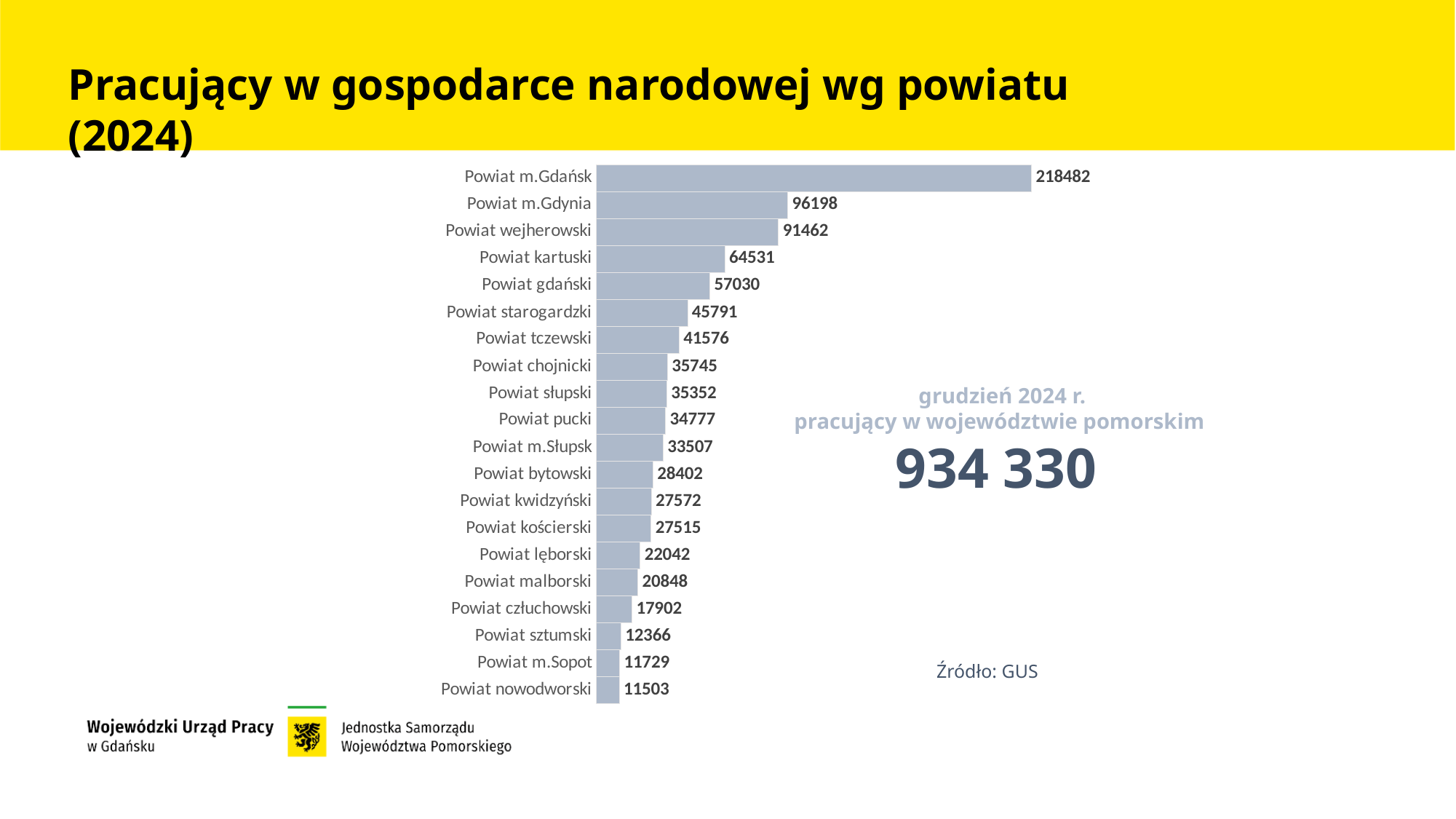
Which powiat has the lowest value? Powiat nowodworski Which powiat has the highest value? Powiat m.Gdańsk What is the total number of employed persons in the Pomorskie voivodeship shown on the slide for December 2024? 934 330 What kind of chart is shown on the slide? Bar chart What is the difference between the values for Powiat m.Gdańsk and Powiat m.Gdynia? 122284 What is the value for Powiat kartuski? 64531 What is the difference between the values for Powiat m.Gdynia and Powiat wejherowski? 4736 What is the value for Powiat m.Sopot? 11729 How many powiats are shown in the chart? 20 What is the value for Powiat m.Gdańsk? 218482 Which is larger, the value for Powiat tczewski or Powiat chojnicki? Powiat tczewski What is the source of the data given on the slide? GUS